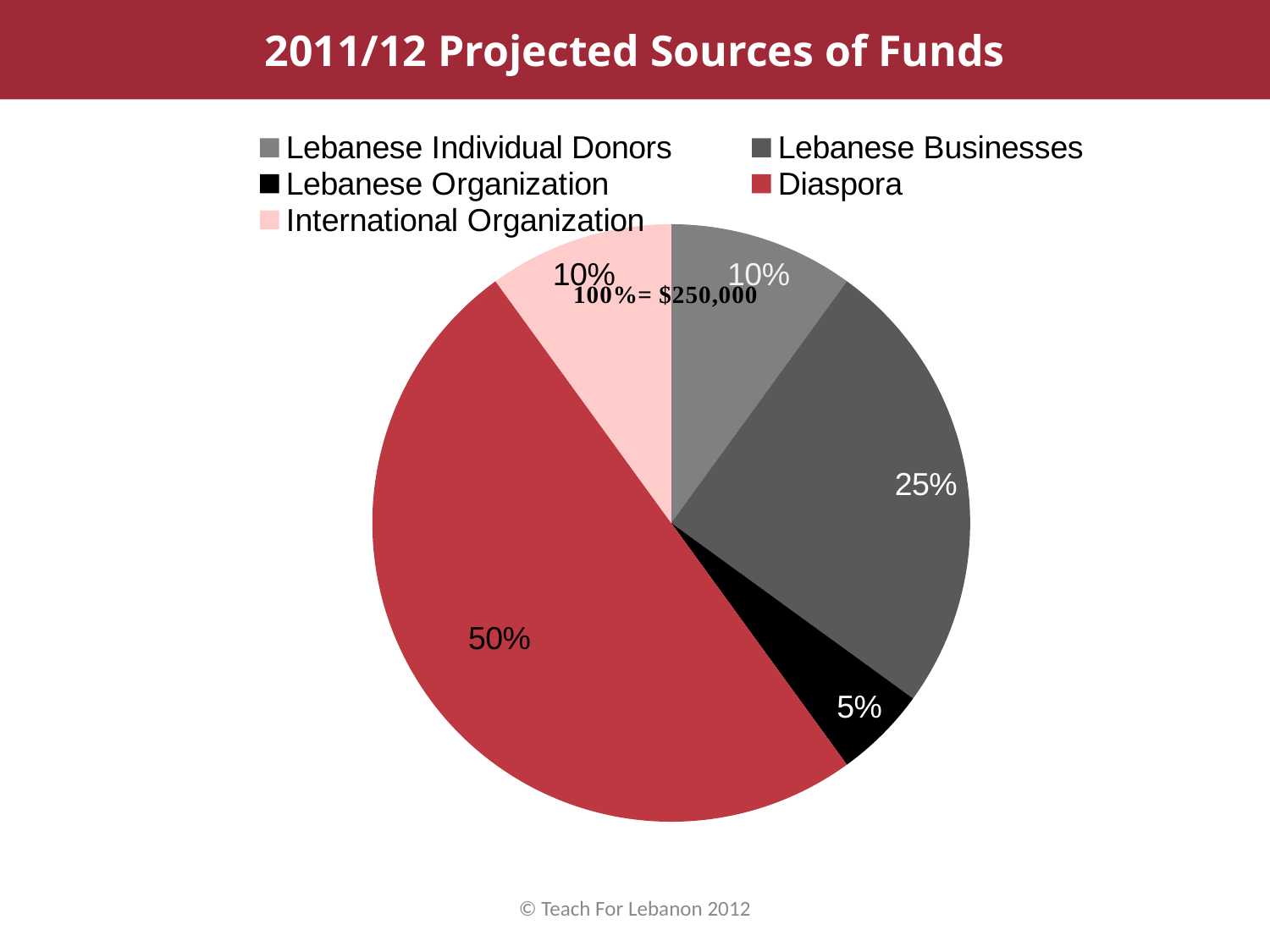
Which is larger, the share for Lebanese Businesses or the share for Lebanese Individual Donors? Lebanese Businesses What is the title of the chart? 2011/12 Projected Sources of Funds According to the note on the chart, what dollar amount does 100% correspond to? $250,000 What share of the pie does International Organization represent? 10% What share of the pie does Diaspora represent? 50% What kind of chart is shown on the slide? pie chart What share of the pie does Lebanese Businesses represent? 25% What is the difference in percentage points between the Diaspora share and the Lebanese Businesses share? 25 How many sources of funds does the legend list? 5 Which source of funds has the smallest share of the pie? Lebanese Organization Which source of funds has the largest share of the pie? Diaspora